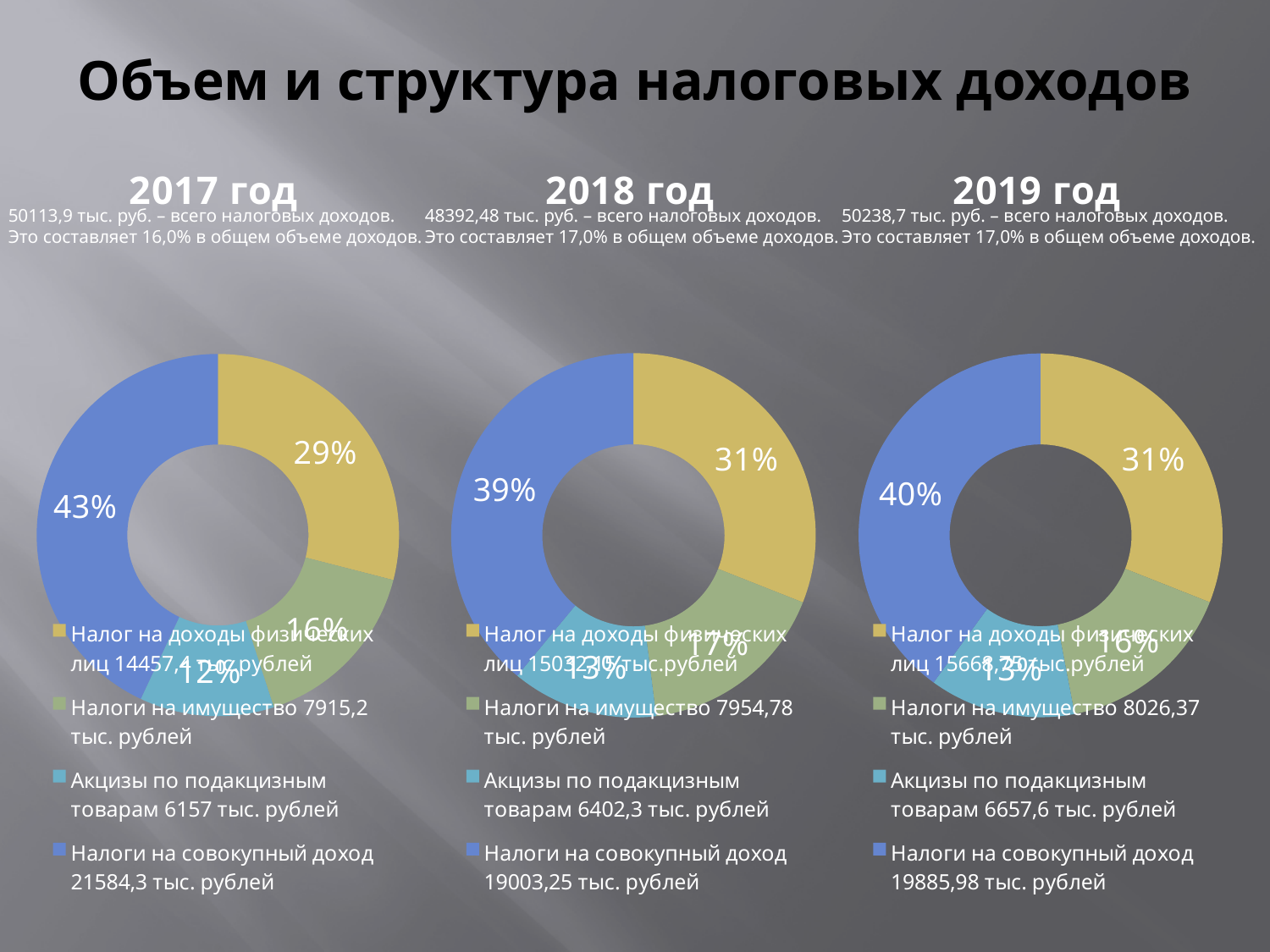
In the 2019 год chart, what share is shown for Налоги на совокупный доход? 40% In the 2019 год chart, which category has the smallest share? Акцизы по подакцизным товарам What kind of chart is used for 2019 год? Doughnut chart What colour represents Налог на доходы физических лиц in the 2017 год chart? Yellow In the 2018 год chart, which is larger: the share for Налоги на имущество or the share for Акцизы по подакцизным товарам? Налоги на имущество According to the legend of the 2018 год chart, what is the value for Налоги на совокупный доход? 19003,25 тыс. рублей How many categories does the 2018 год chart show? 4 In the 2017 год chart, what is the difference in percentage points between the share for Налоги на совокупный доход and the share for Налог на доходы физических лиц? 14% In the 2017 год chart, what share of the doughnut is Налоги на совокупный доход? 43% In the 2017 год chart, which category has the largest share? Налоги на совокупный доход In the 2018 год chart, what share is shown for Налог на доходы физических лиц? 31% According to the legend of the 2019 год chart, what is the value for Акцизы по подакцизным товарам? 6657,6 тыс. рублей